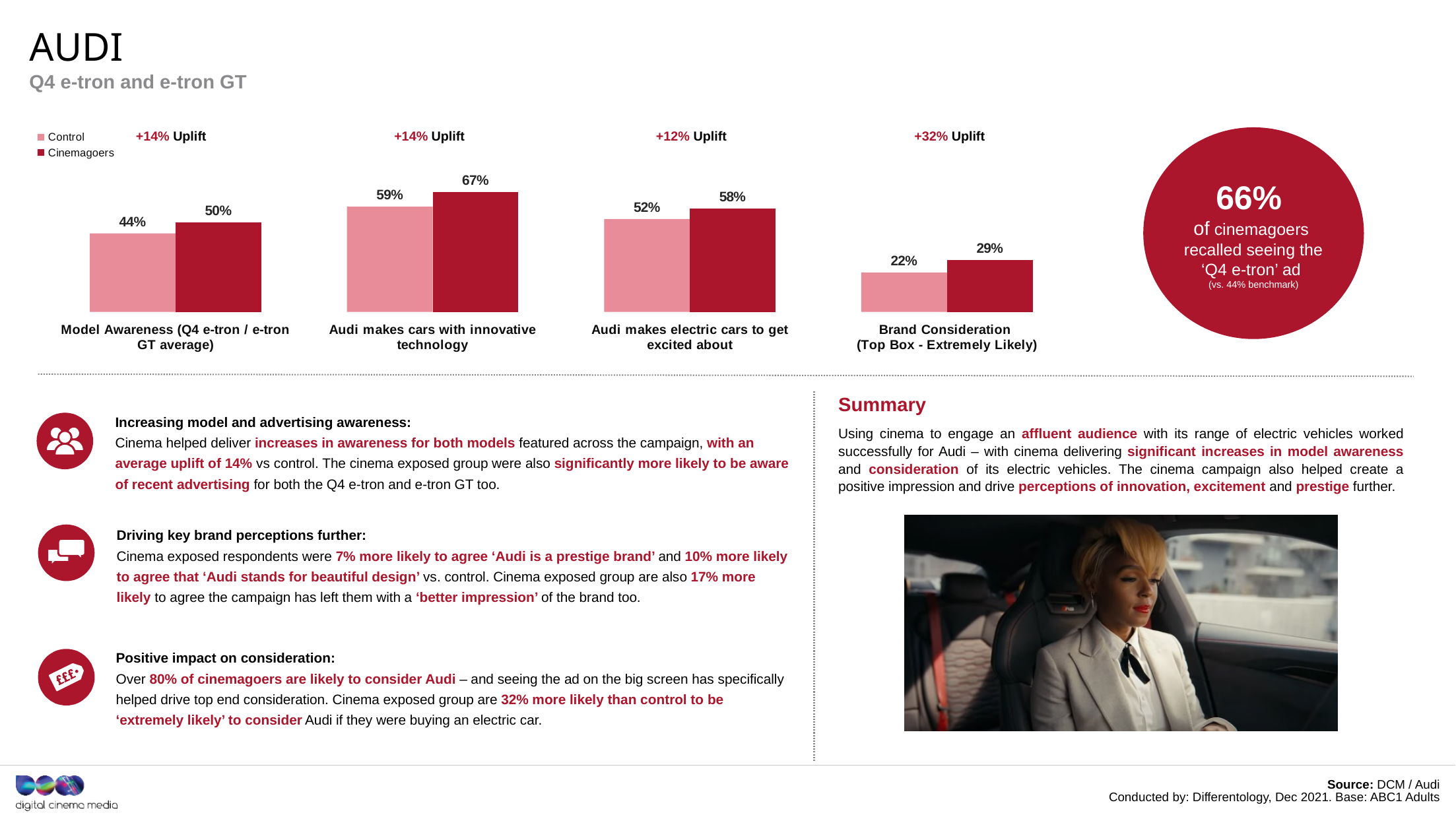
What uplift is shown above the 'Brand Consideration (Top Box - Extremely Likely)' chart? +32% Uplift In the 'Audi makes cars with innovative technology' chart, what is the value for Cinemagoers? 67% What kind of chart is used for 'Model Awareness (Q4 e-tron / e-tron GT average)'? Bar chart In the 'Brand Consideration (Top Box - Extremely Likely)' chart, what is the value for Cinemagoers? 29% In the 'Model Awareness (Q4 e-tron / e-tron GT average)' chart, what is the value for Cinemagoers? 50% In the 'Audi makes cars with innovative technology' chart, what is the difference between the Cinemagoers and Control values? 8% Which of the four bar charts shows the lowest Control value? Brand Consideration (Top Box - Extremely Likely) How many series does the legend list for the bar charts? 2 In the 'Brand Consideration (Top Box - Extremely Likely)' chart, what is the difference between the Cinemagoers and Control values? 7% In the 'Audi makes electric cars to get excited about' chart, what is the value for Control? 52% In the 'Audi makes electric cars to get excited about' chart, which is larger, Control or Cinemagoers? Cinemagoers In the 'Model Awareness (Q4 e-tron / e-tron GT average)' chart, what is the value for Control? 44%